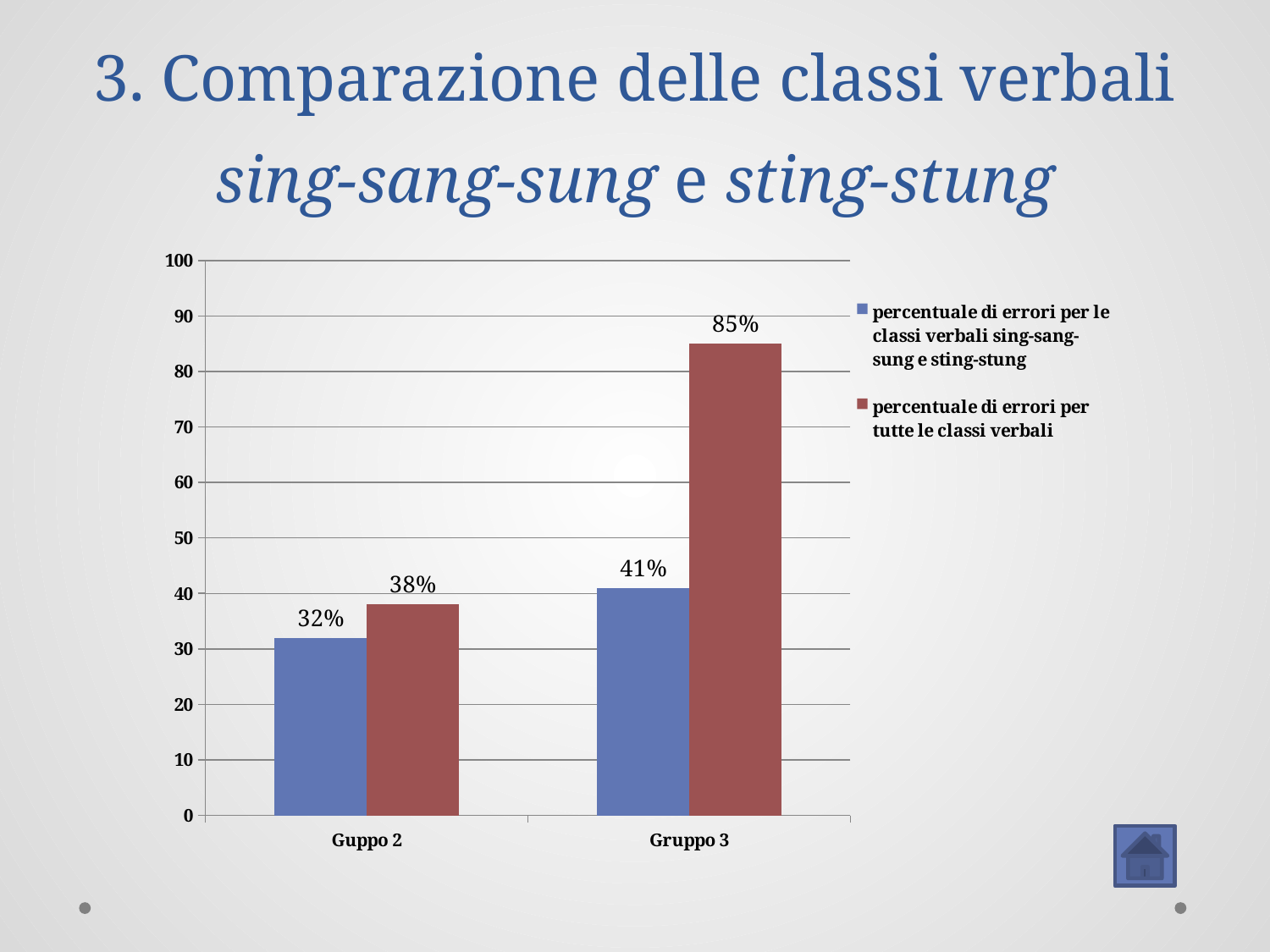
What is the percentage of errors for the verb classes sing-sang-sung and sting-stung for Gruppo 3? 41% For Guppo 2, which is larger: the percentage of errors for the sing-sang-sung and sting-stung classes or for all verb classes? all verb classes Which group has the lowest percentage of errors for the verb classes sing-sang-sung and sting-stung? Guppo 2 How many series does the legend list? 2 What kind of chart is shown on the slide? bar chart What is the difference between the percentage of errors for all verb classes and for the sing-sang-sung and sting-stung classes in Gruppo 3? 44% Which group has the highest percentage of errors for all verb classes? Gruppo 3 What is the percentage of errors for all verb classes for Gruppo 3? 85% How many groups are shown on the x axis? 2 What is the percentage of errors for all verb classes for Guppo 2? 38% What is the percentage of errors for the verb classes sing-sang-sung and sting-stung for Guppo 2? 32% What is the difference in the percentage of errors for all verb classes between Gruppo 3 and Guppo 2? 47%